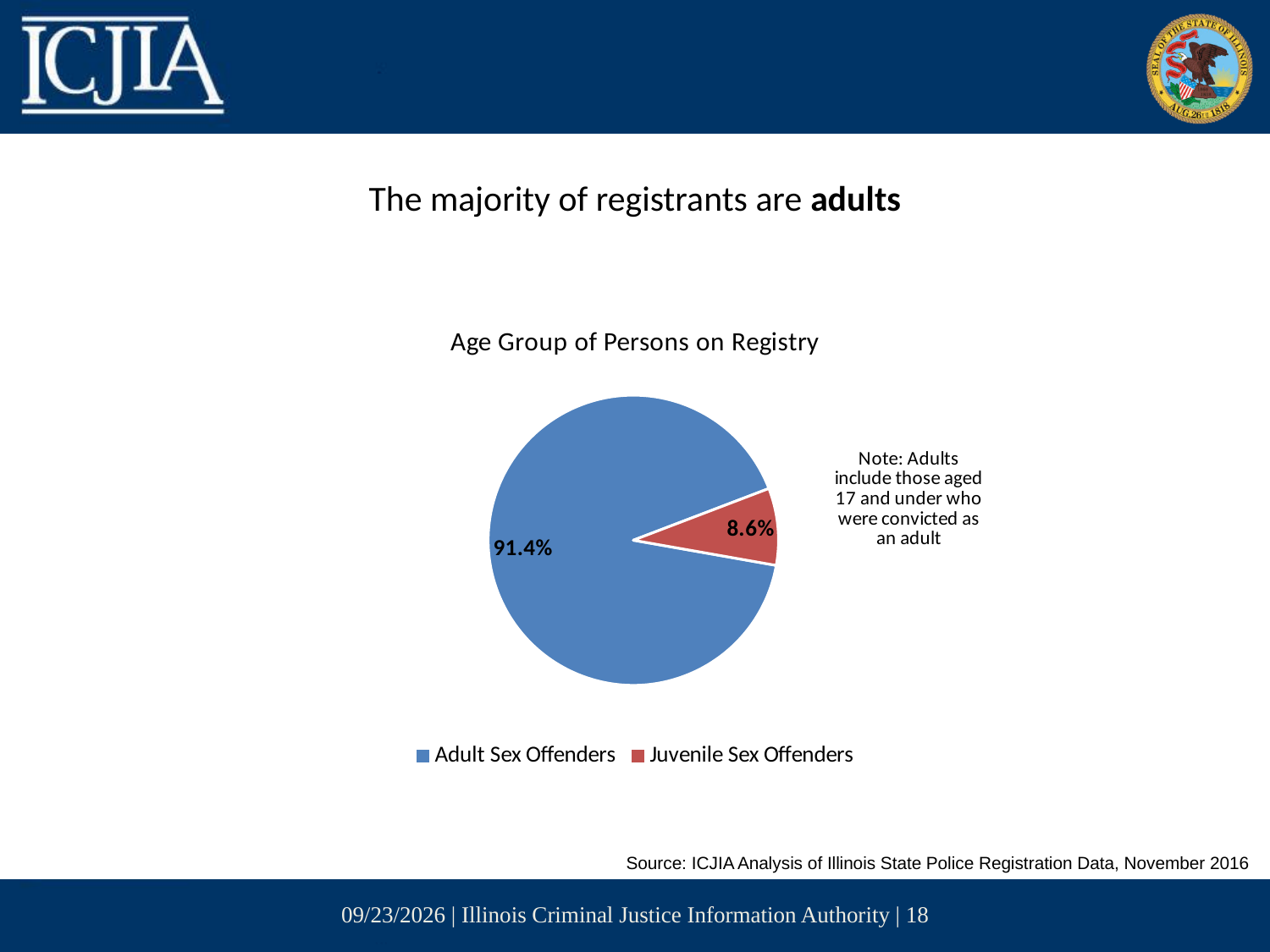
What share of the pie does the Adult Sex Offenders slice represent? 91.4% What percentage of persons on the registry are Juvenile Sex Offenders? 8.6% What is the difference in percentage points between Adult Sex Offenders and Juvenile Sex Offenders? 82.8 Which category has the smallest share of the pie? Juvenile Sex Offenders What type of chart is shown on the slide? Pie chart How many categories does the pie chart show? 2 How many entries does the legend list? 2 Which category has the largest share of the pie? Adult Sex Offenders What percentage of persons on the registry are Adult Sex Offenders? 91.4% Which is larger: the share for Adult Sex Offenders or Juvenile Sex Offenders? Adult Sex Offenders What colour represents Juvenile Sex Offenders in the pie chart? Red What is the title of the chart? Age Group of Persons on Registry